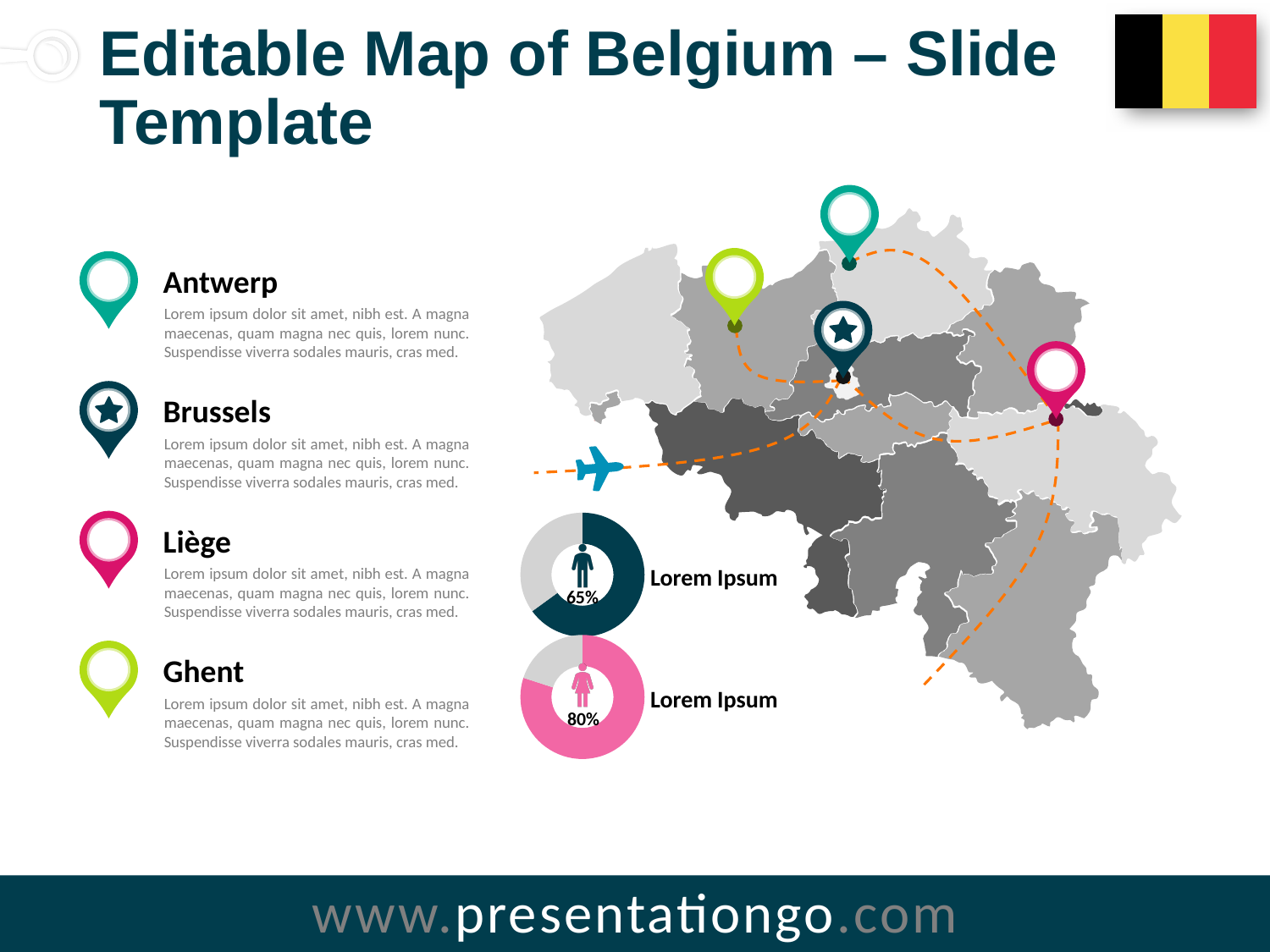
What colour is the filled portion of the lower donut chart showing 80%? Pink Which donut chart shows the smaller value, the one with the male icon or the one with the female icon? The one with the male icon How many donut charts are shown on the slide? 2 What value is shown on the upper donut chart with the male figure icon? 65% Is the value on the upper dark teal donut chart greater or less than 50%? greater Which donut chart shows the larger value, the upper (dark teal) one or the lower (pink) one? The lower (pink) one What label text appears next to each of the two donut charts? Lorem Ipsum What kind of chart is used to display the 65% and 80% values? Donut chart What is the difference between the value on the lower pink donut chart and the value on the upper dark teal donut chart? 15% What value is shown on the lower donut chart with the female figure icon? 80% Is the value on the lower pink donut chart greater or less than 75%? greater